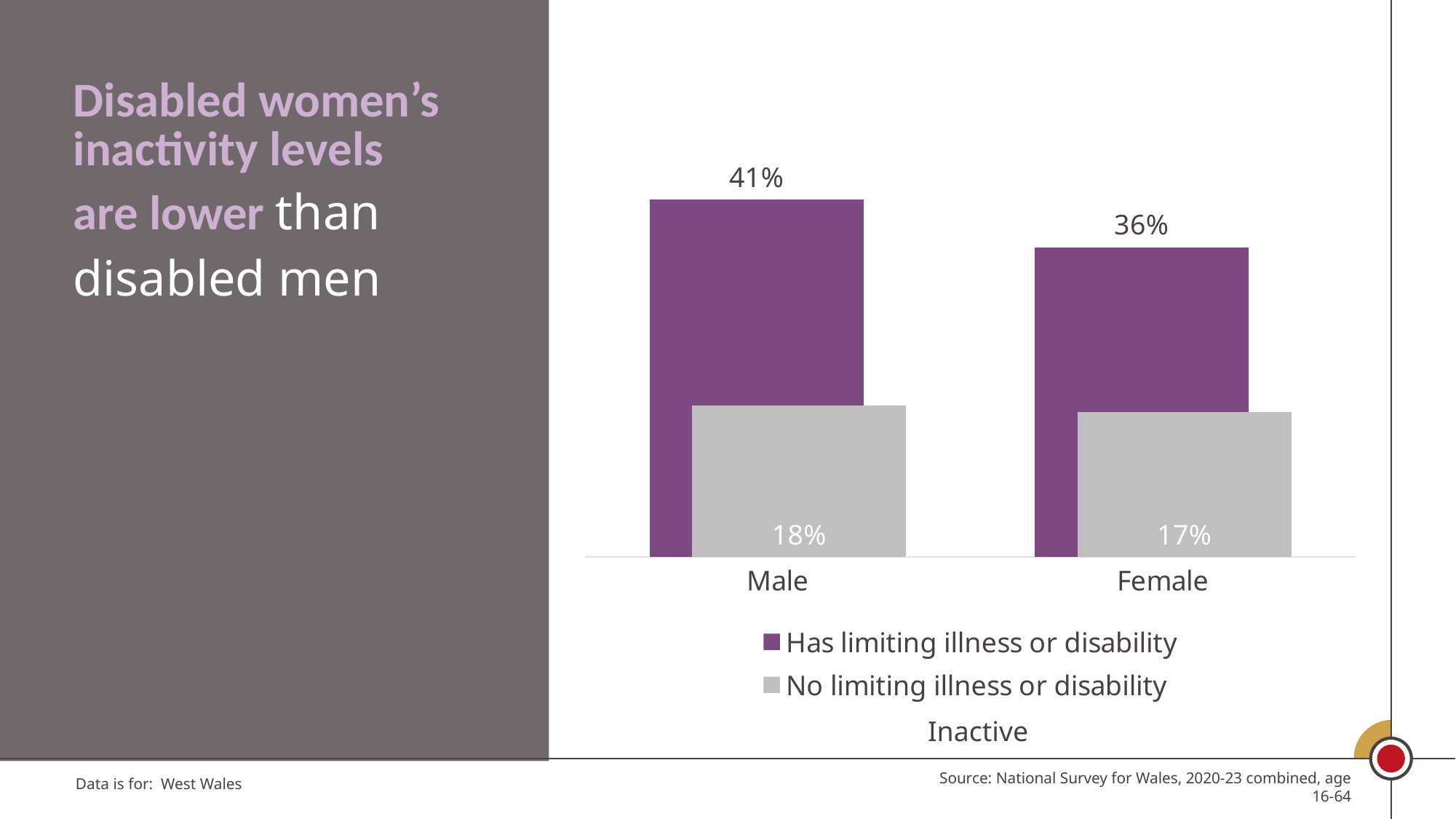
What is the inactivity rate for females who have a limiting illness or disability? 36% Is the inactivity rate for males with a limiting illness or disability higher or lower than for females with a limiting illness or disability? higher Which category has the highest inactivity rate among those with a limiting illness or disability? Male Which series is shown in purple? Has limiting illness or disability What is the difference between the male and female inactivity rates for those with a limiting illness or disability? 5% What kind of chart is shown on the slide? bar chart What is the inactivity rate for males who have a limiting illness or disability? 41% What is the inactivity rate for females with no limiting illness or disability? 17% What is the difference between the inactivity rates for males with and without a limiting illness or disability? 23% What is the inactivity rate for males with no limiting illness or disability? 18% How many categories are shown on the x axis? 2 How many series does the legend list? 2